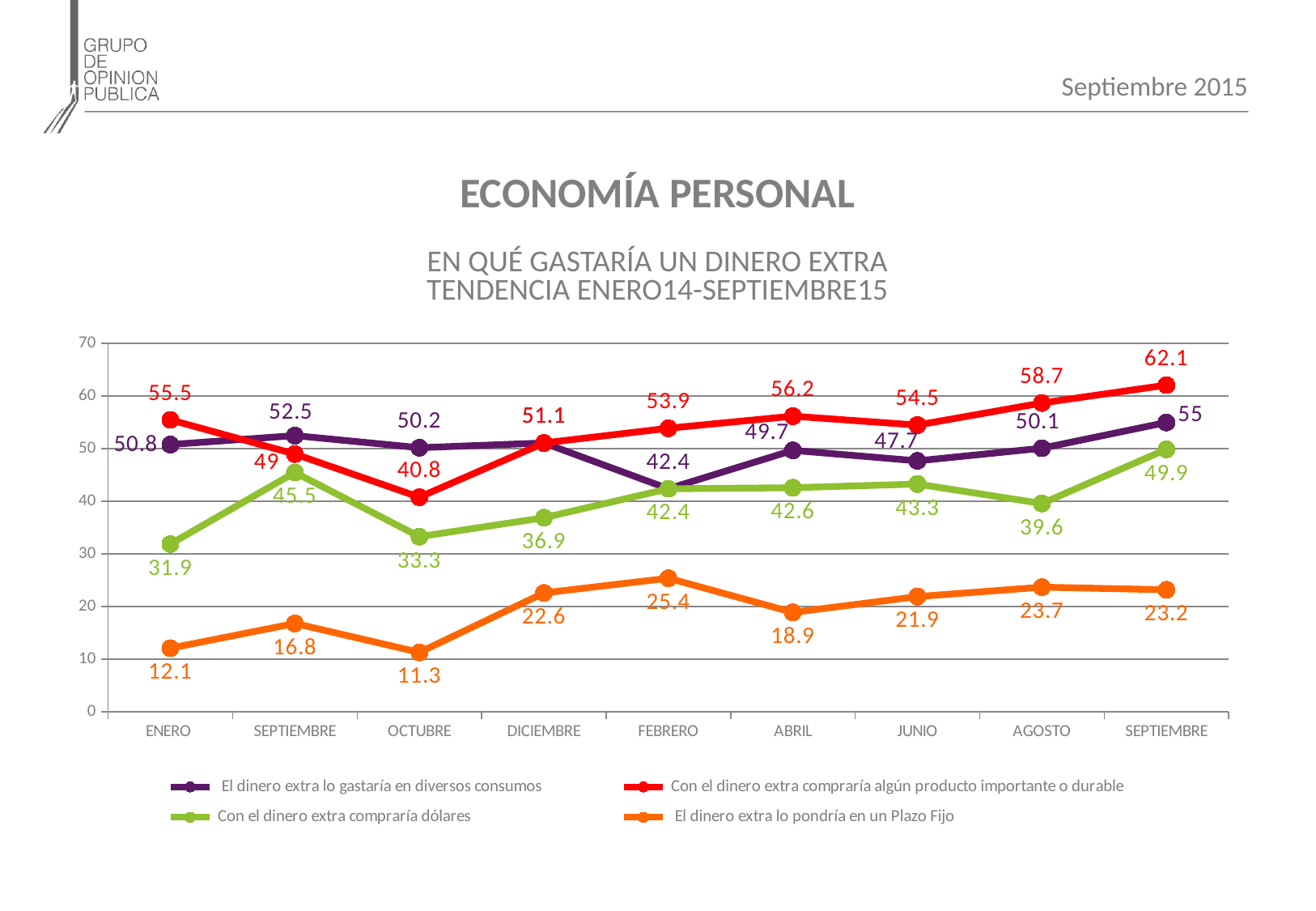
What is the value for 'Con el dinero extra compraría dólares' in OCTUBRE? 33.3 At the final SEPTIEMBRE point, what is the difference between 'Con el dinero extra compraría algún producto importante o durable' (62.1) and 'El dinero extra lo gastaría en diversos consumos' (55)? 7.1 In ENERO, which is larger: 'El dinero extra lo gastaría en diversos consumos' or 'Con el dinero extra compraría algún producto importante o durable'? Con el dinero extra compraría algún producto importante o durable What colour is the line for 'El dinero extra lo pondría en un Plazo Fijo'? orange How many months are shown on the x axis? 9 From OCTUBRE to the final SEPTIEMBRE, do the values for 'Con el dinero extra compraría algún producto importante o durable' generally rise or fall? rise Is the value for 'El dinero extra lo gastaría en diversos consumos' in DICIEMBRE greater or less than 40? greater What is the value for 'El dinero extra lo pondría en un Plazo Fijo' in FEBRERO? 25.4 In which month does 'Con el dinero extra compraría algún producto importante o durable' reach its highest value? SEPTIEMBRE (the last point, 62.1) What kind of chart is shown on the slide? line chart How many series does the legend list? 4 In which month is 'El dinero extra lo pondría en un Plazo Fijo' at its lowest? OCTUBRE